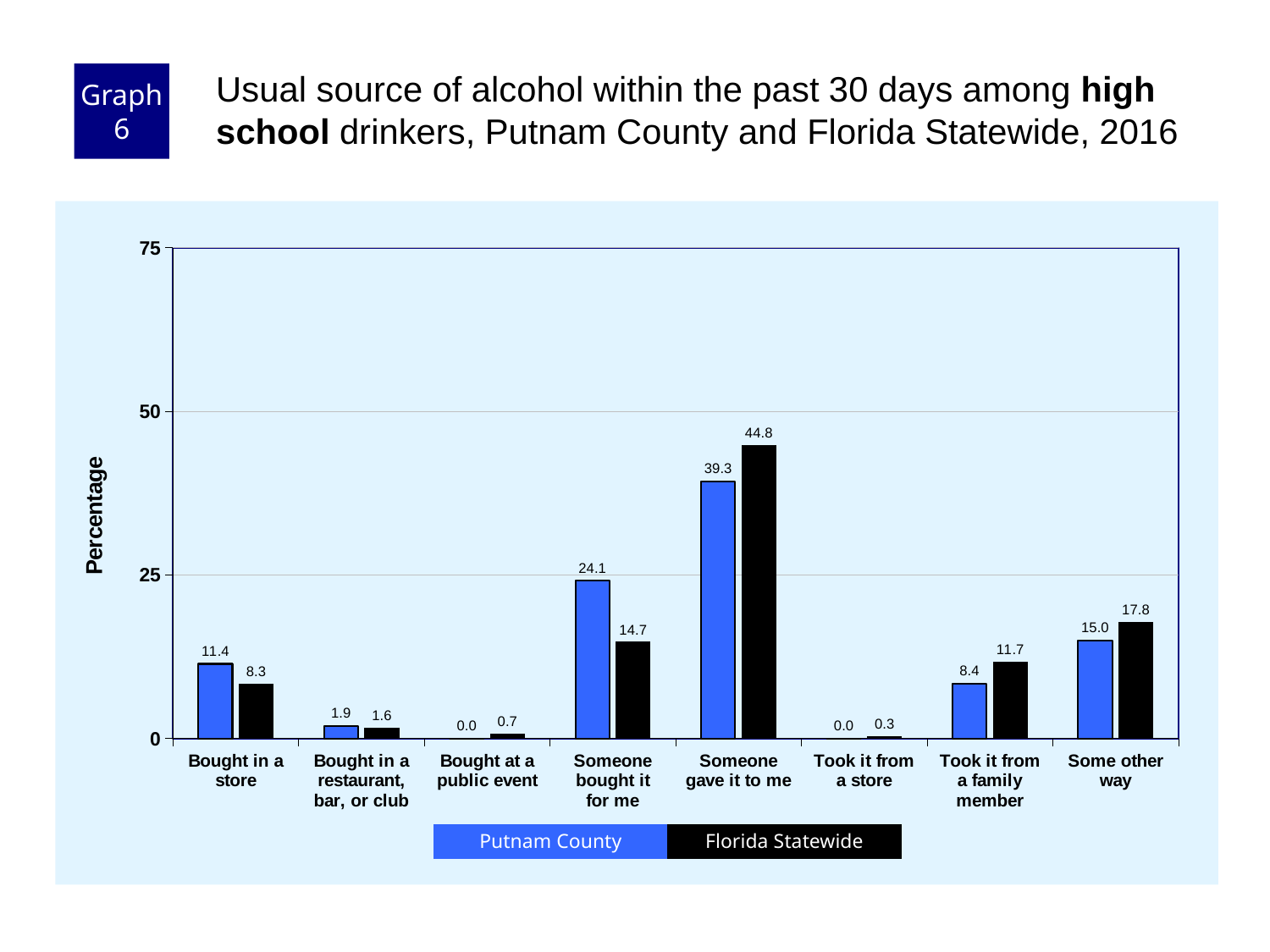
How many series does the legend list? 2 Is the Florida Statewide value for "Someone gave it to me" greater or less than 50? less Which category has the lowest Florida Statewide value? Took it from a store Which category has the highest Florida Statewide value? Someone gave it to me What kind of chart is shown on the slide? Bar chart How many categories are shown on the x axis? 8 What is the Putnam County value for "Someone gave it to me"? 39.3 What is the label of the y axis? Percentage What is the Florida Statewide value for "Someone bought it for me"? 14.7 What is the difference between the Florida Statewide and Putnam County values for "Someone gave it to me"? 5.5 Which is larger for "Someone bought it for me": Putnam County or Florida Statewide? Putnam County What is the Putnam County value for "Bought in a store"? 11.4